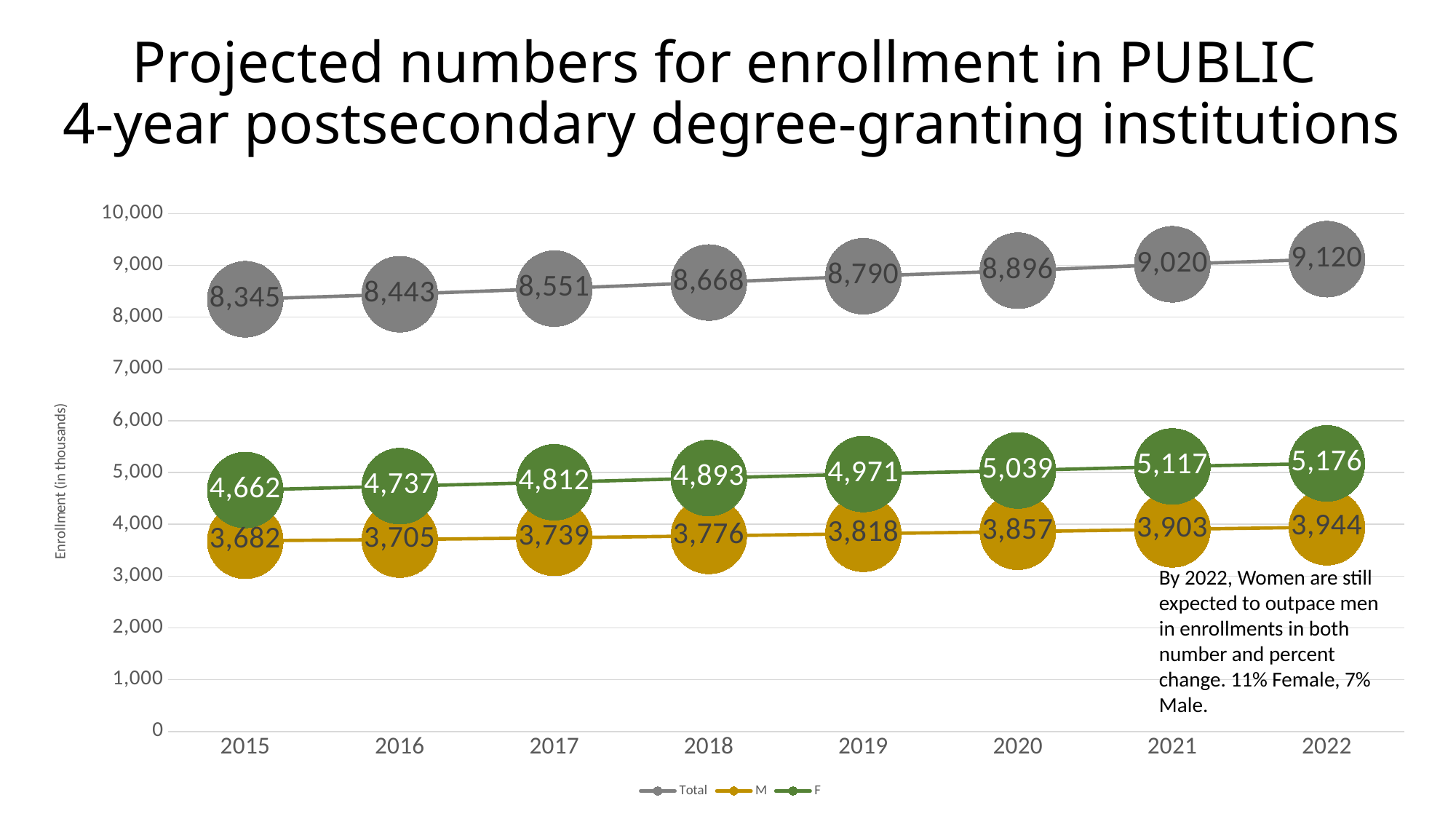
Do the F (female) enrollment values rise or fall from 2015 to 2022? Rise Which is larger in 2019, the F value or the M value? F What is the projected M (male) enrollment for 2015? 3,682 How many years are shown on the x axis? 8 What is the difference between the F and M enrollment values in 2022? 1,232 In which year is the Total enrollment highest? 2022 What kind of chart is shown on the slide? Line chart What is the projected Total enrollment for 2022? 9,120 Is the Total enrollment for 2015 greater or less than 8,000? greater How many series does the legend list? 3 In which year is the M (male) enrollment lowest? 2015 What is the projected F (female) enrollment for 2018? 4,893